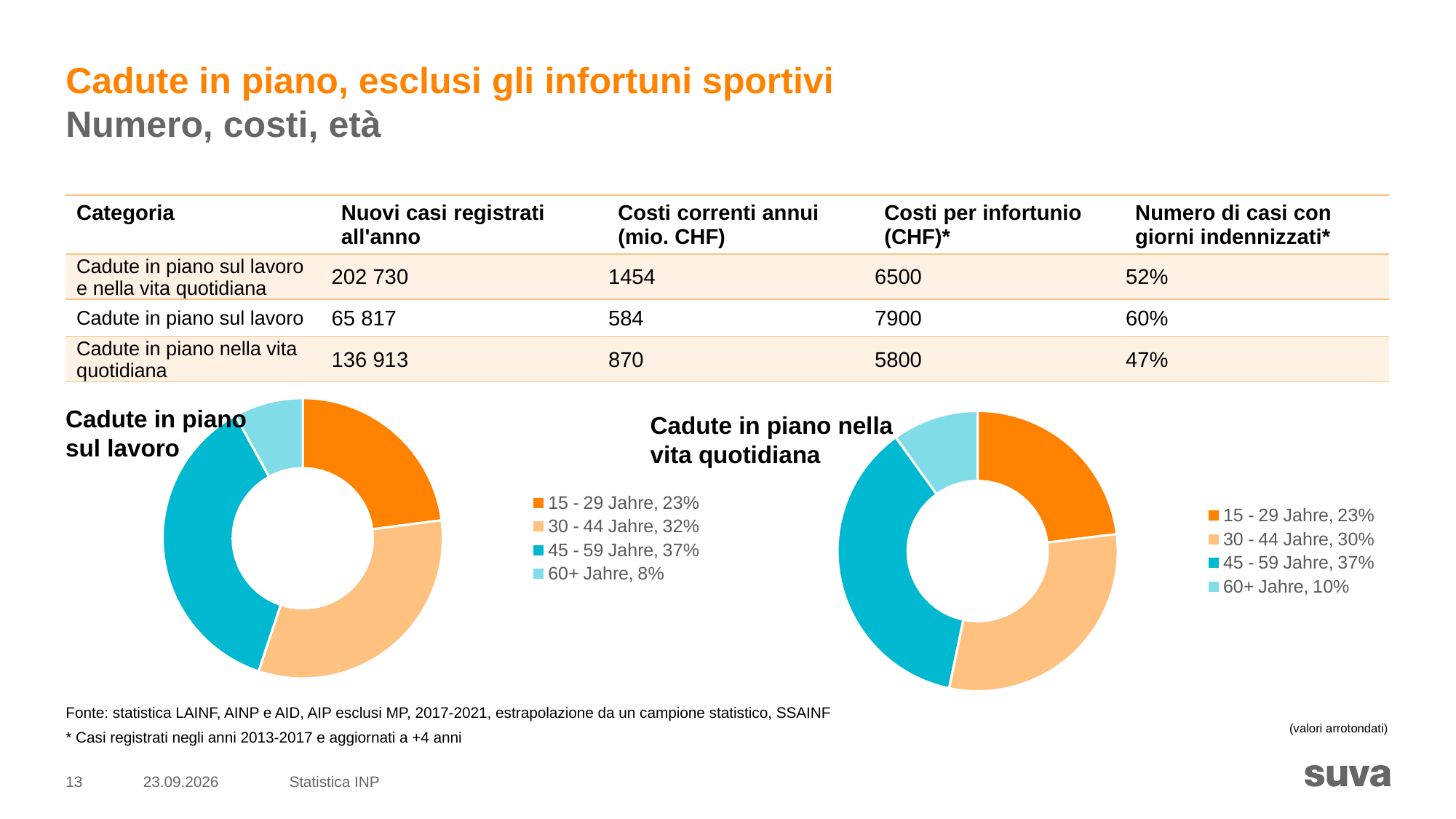
In the 'Cadute in piano sul lavoro' chart, what share is shown for 30 - 44 Jahre? 32% In the 'Cadute in piano sul lavoro' chart, what share is shown for 45 - 59 Jahre? 37% How many entries does the legend of the 'Cadute in piano sul lavoro' chart list? 4 How many age groups does the 'Cadute in piano nella vita quotidiana' chart show? 4 In the 'Cadute in piano nella vita quotidiana' chart, what is the difference in percentage points between the 30 - 44 Jahre and 60+ Jahre shares? 20 In the 'Cadute in piano sul lavoro' chart, what is the difference in percentage points between the 45 - 59 Jahre and 15 - 29 Jahre shares? 14 In the 'Cadute in piano sul lavoro' chart, which age group has the smallest share? 60+ Jahre In the 'Cadute in piano nella vita quotidiana' chart, which colour represents 15 - 29 Jahre? orange What kind of chart is used for 'Cadute in piano sul lavoro'? doughnut chart Is the share for 30 - 44 Jahre larger in the 'Cadute in piano sul lavoro' chart or in the 'Cadute in piano nella vita quotidiana' chart? Cadute in piano sul lavoro In the 'Cadute in piano nella vita quotidiana' chart, what share is shown for 60+ Jahre? 10% In the 'Cadute in piano nella vita quotidiana' chart, which age group has the largest share? 45 - 59 Jahre